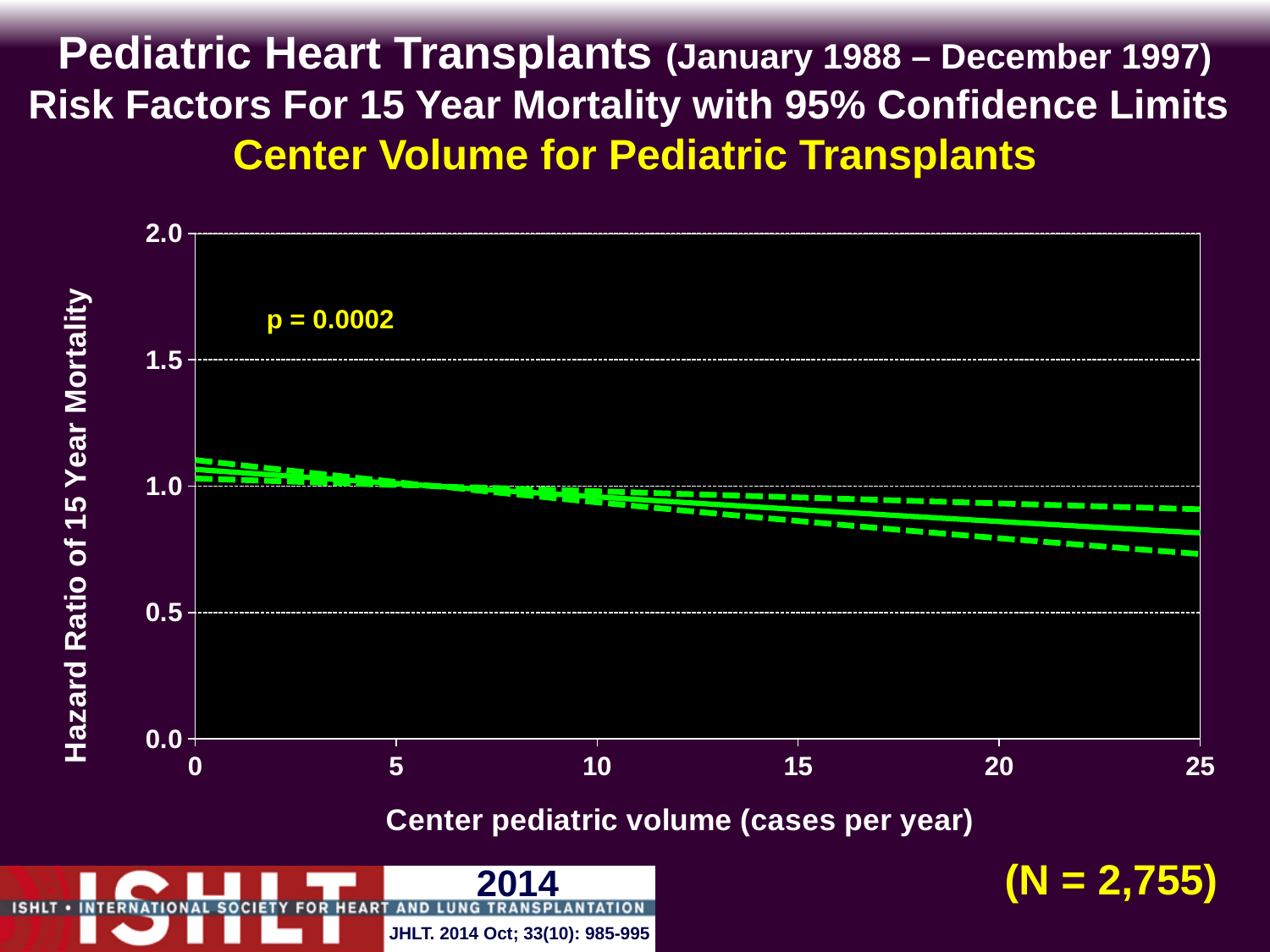
What is the maximum value shown on the y axis of the chart? 2.0 Is the upper confidence limit at a center pediatric volume of 25 cases per year greater or less than 1.0? less Is the hazard ratio at a center pediatric volume of 25 cases per year greater or less than 1.0? less Does the hazard ratio of 15 year mortality rise or fall as center pediatric volume increases along the x axis? fall What is the p-value printed on the chart? p = 0.0002 What kind of chart is shown on the slide? line chart What is the label of the x axis of the chart? Center pediatric volume (cases per year) Is the hazard ratio at a center pediatric volume of 20 cases per year greater or less than 0.5? greater What is the maximum value shown on the x axis of the chart? 25